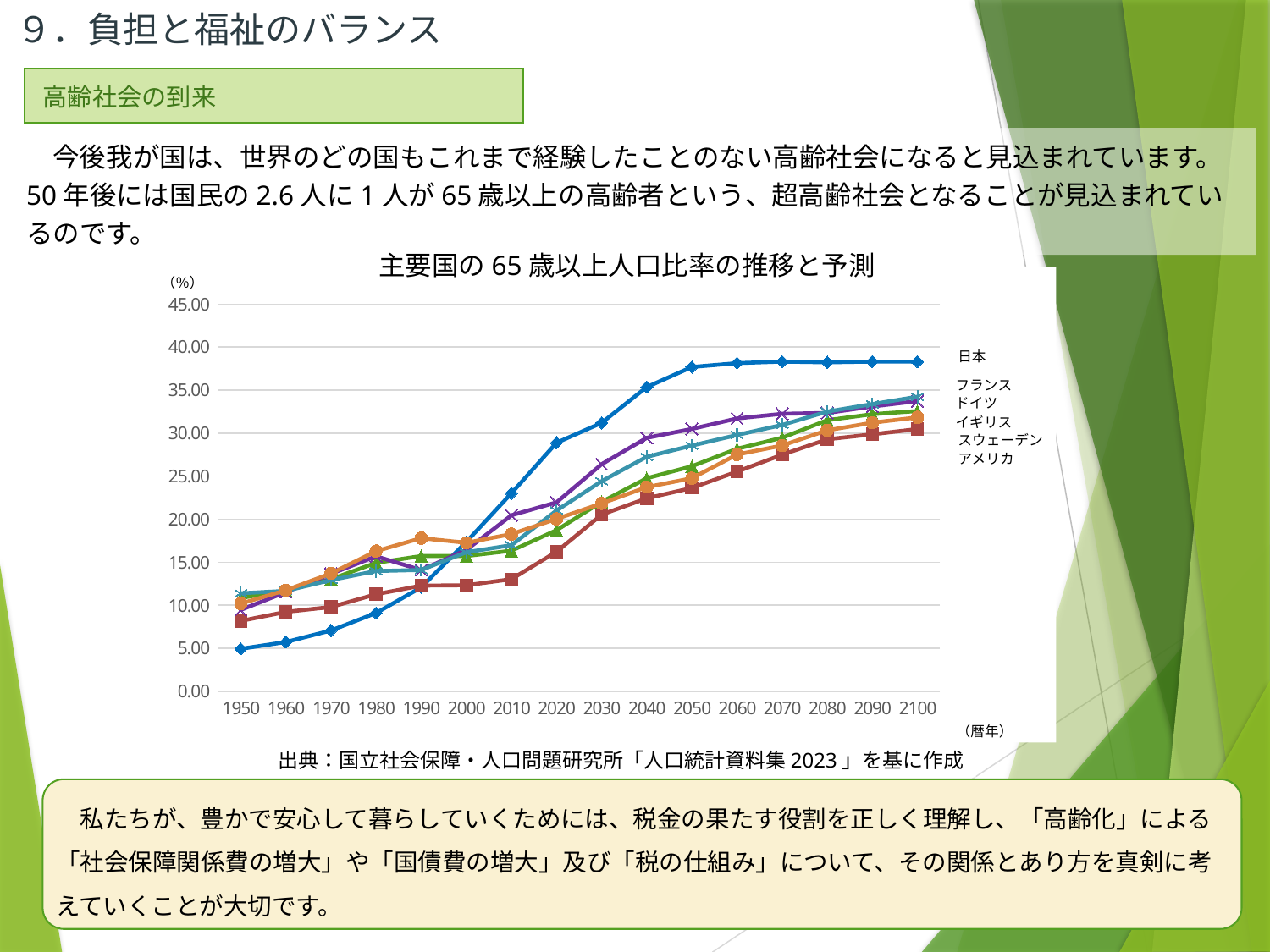
What kind of chart is shown on the slide? line chart Does the value for 日本 rise or fall from 1950 to 2050? rise How many series does the legend of the chart list? 6 What is the title of the chart? 主要国の65歳以上人口比率の推移と予測 Is the value for 日本 in 2020 greater or less than 25.00? greater Which country has the lowest value in 1950? 日本 Is the value for 日本 in 2050 greater or less than 35.00? greater Which country has the highest value in 2100? 日本 How many years are shown along the x axis of the chart? 16 Is the value for アメリカ in 2000 greater or less than 15.00? less Which is larger in 2100, the value for 日本 or the value for アメリカ? 日本